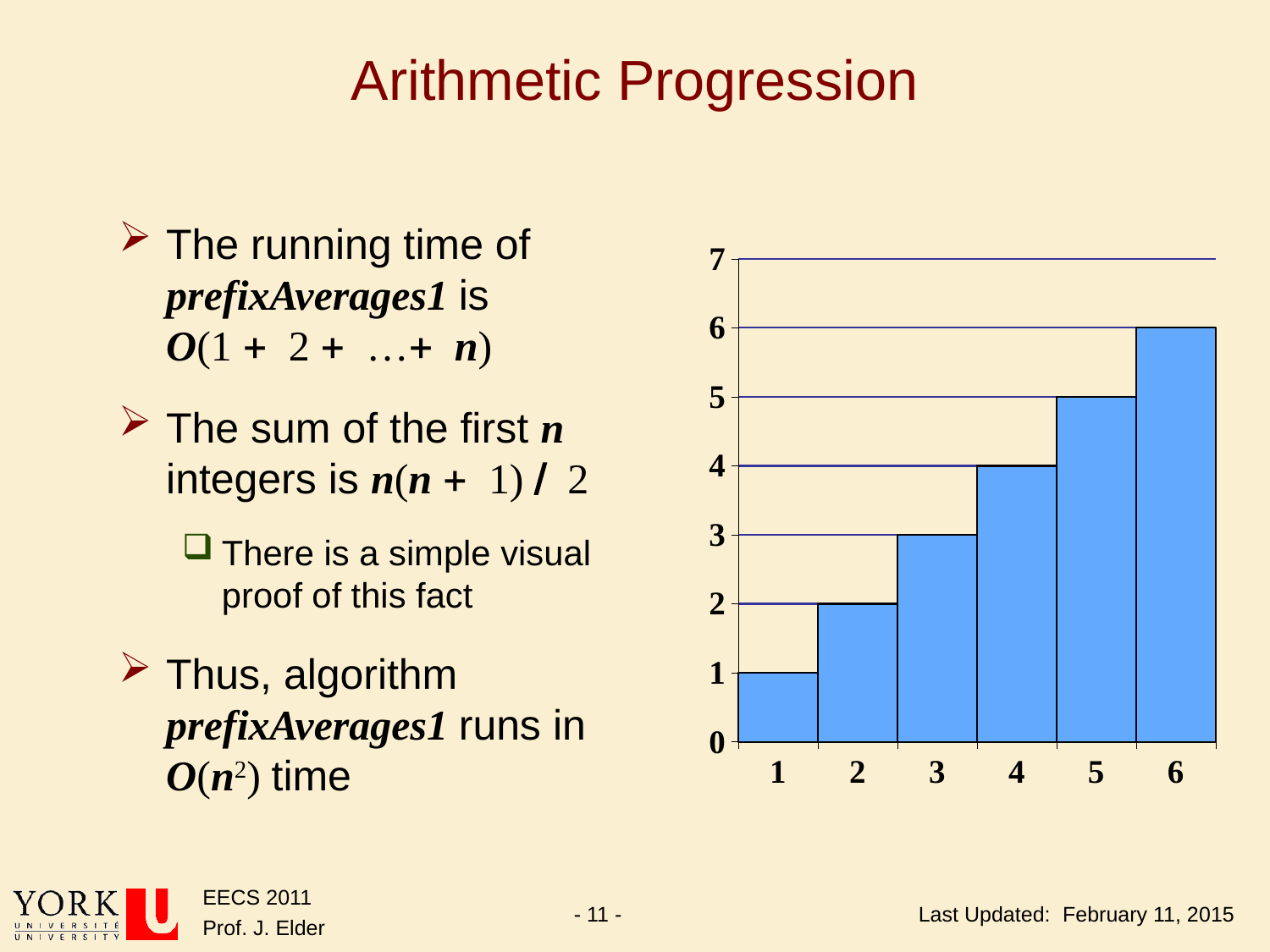
What is the difference between the values for category 5 and category 2? 3 What is the value of the bar for category 3? 3 Which is larger, the bar for category 4 or the bar for category 2? category 4 How many bars are plotted in the chart? 6 Which category has the highest bar? 6 Which category has the lowest bar? 1 Do the bar values rise or fall from left to right along the x axis? rise What colour are the bars in the chart? blue What is the value of the bar for category 6? 6 What is the value of the bar for category 1? 1 What kind of chart is shown on the slide? bar chart What is the highest value shown on the y axis? 7